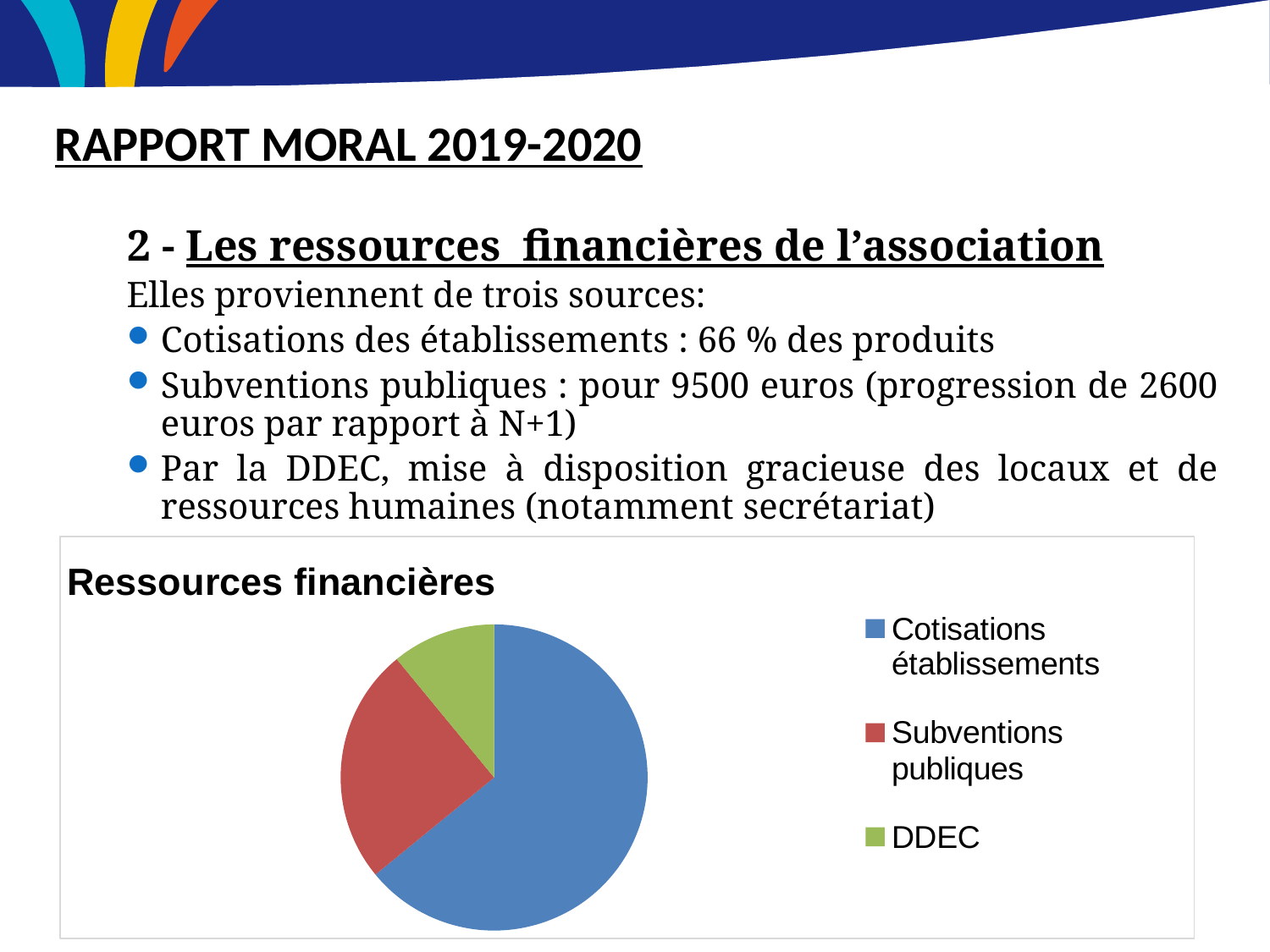
What colour is the slice for Subventions publiques? red How many entries does the chart legend list? 3 Which category has the largest slice of the pie? Cotisations établissements What is the title of the chart? Ressources financières Which category has the smallest slice of the pie? DDEC Which slice is larger, Cotisations établissements or Subventions publiques? Cotisations établissements How many slices does the pie chart have? 3 What kind of chart is shown on the slide? pie chart Which slice is larger, Subventions publiques or DDEC? Subventions publiques